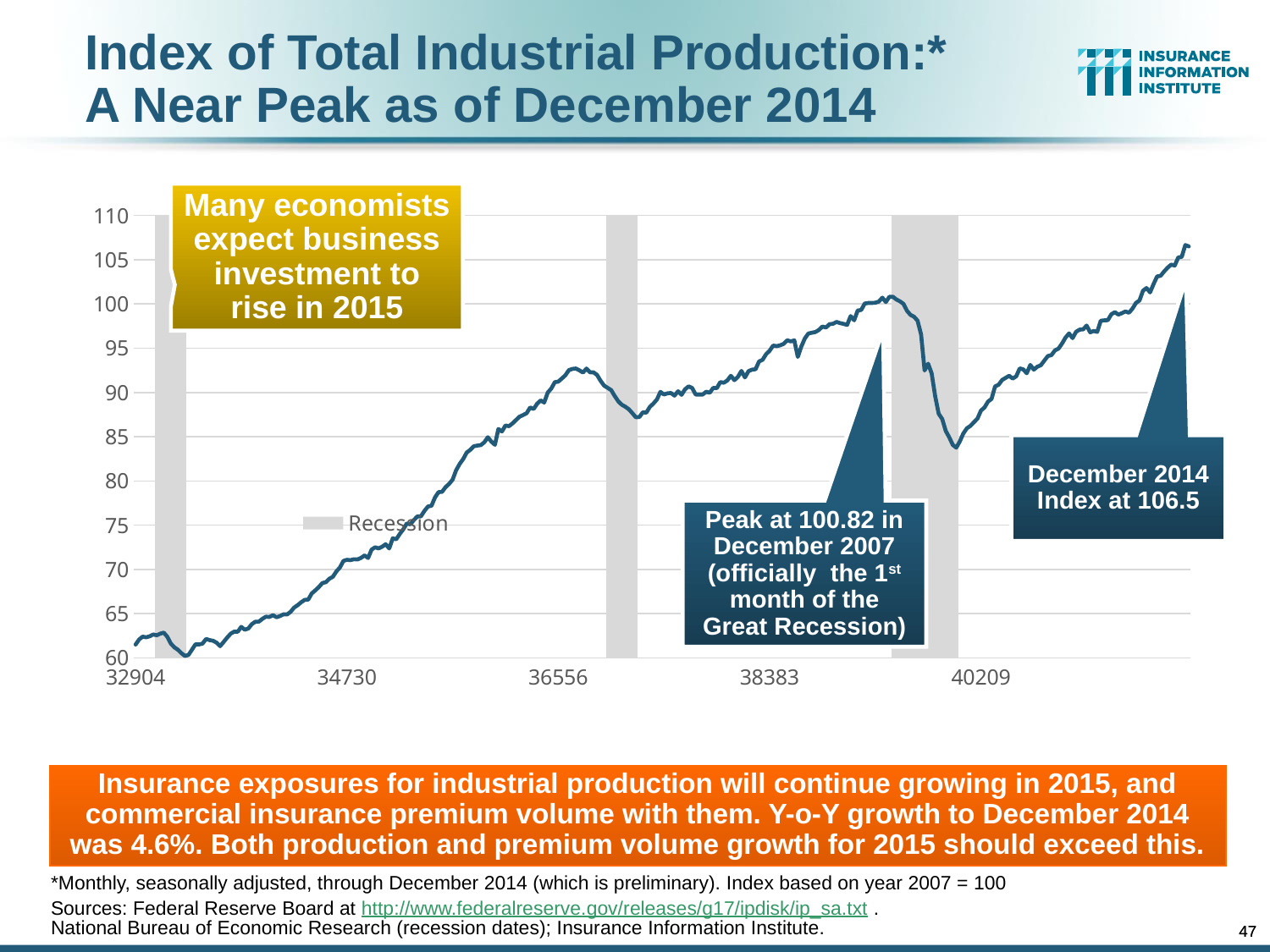
What kind of chart is shown on the slide? line chart Which is higher: the index in December 2007 or the index in December 2014? December 2014 What is the highest value shown on the vertical axis of the chart? 110 Is the index value at the left edge of the chart greater or less than 65? less Is the lowest index value reached during the Great Recession trough greater or less than 90? less How many shaded recession periods are marked on the chart? 3 What was the peak value of the index in December 2007? 100.82 By how much does the December 2014 index value exceed the December 2007 peak? 5.68 Overall, does the index rise or fall from the left of the chart to the right? rise What was the value of the Index of Total Industrial Production in December 2014? 106.5 Is the lowest index value reached during the Great Recession trough greater or less than 80? greater What do the gray shaded bands on the chart represent, according to the legend? Recession